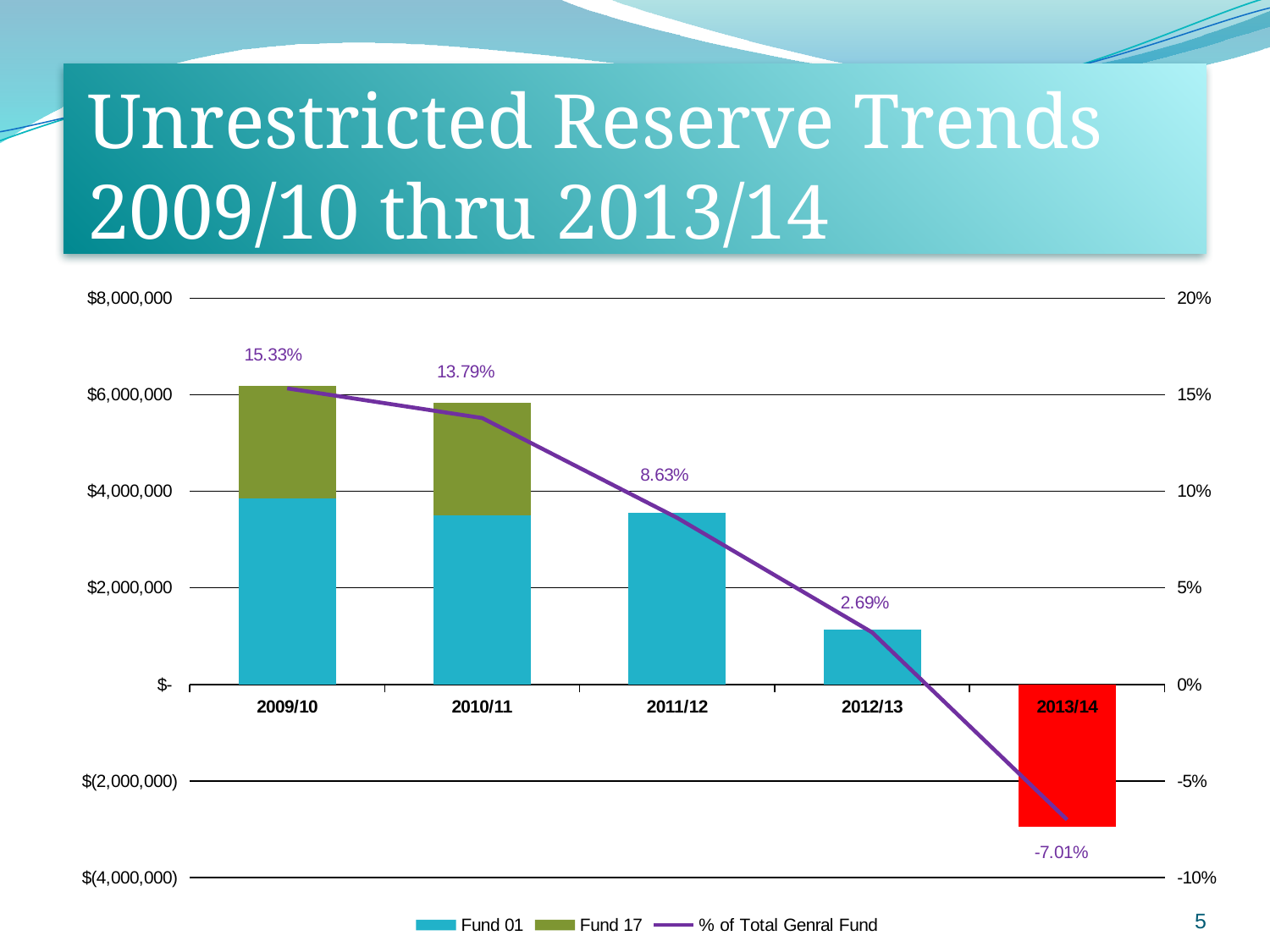
What is the % of Total General Fund value for 2009/10? 15.33% What is the % of Total General Fund value for 2011/12? 8.63% Is the Fund 01 value for 2011/12 greater or less than $4,000,000? less What is the % of Total General Fund value for 2013/14? -7.01% What is the difference in % of Total General Fund between 2011/12 and 2012/13? 5.94 percentage points What is the difference in % of Total General Fund between 2009/10 and 2010/11? 1.54 percentage points Which year has the lowest % of Total General Fund? 2013/14 How many fiscal years are shown on the x axis? 5 Which year has the highest % of Total General Fund? 2009/10 How many series does the legend list? 3 Does the % of Total General Fund line rise or fall from 2009/10 to 2013/14? fall Which year has a larger % of Total General Fund, 2010/11 or 2012/13? 2010/11